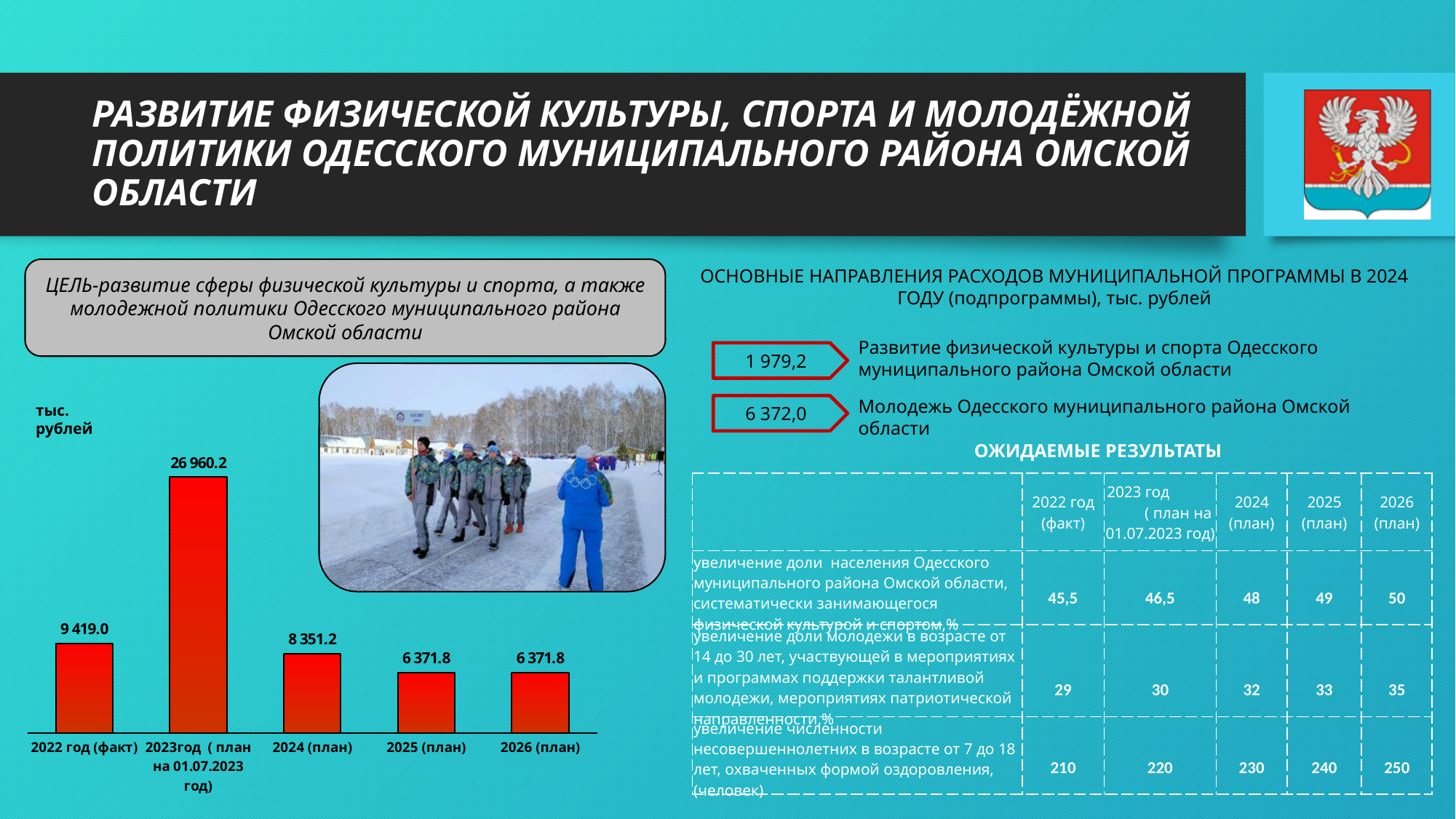
What unit is indicated for the values in the bar chart? тыс. рублей What is the value for 2022 год (факт) in the bar chart? 9 419.0 What type of chart is shown on the left of the slide? bar chart What is the value for 2023год (план на 01.07.2023 год) in the bar chart? 26 960.2 How many bars (categories) does the bar chart show? 5 Do the values in the bar chart rise or fall from 2024 (план) to 2026 (план)? fall What is the value for 2024 (план) in the bar chart? 8 351.2 What is the difference between the values for 2023год (план на 01.07.2023 год) and 2024 (план) in the bar chart? 18 609.0 Which value is larger in the bar chart: 2022 год (факт) or 2024 (план)? 2022 год (факт) What is the difference between the values for 2022 год (факт) and 2025 (план) in the bar chart? 3 047.2 Which category has the highest value in the bar chart? 2023год (план на 01.07.2023 год) What is the value for 2025 (план) in the bar chart? 6 371.8